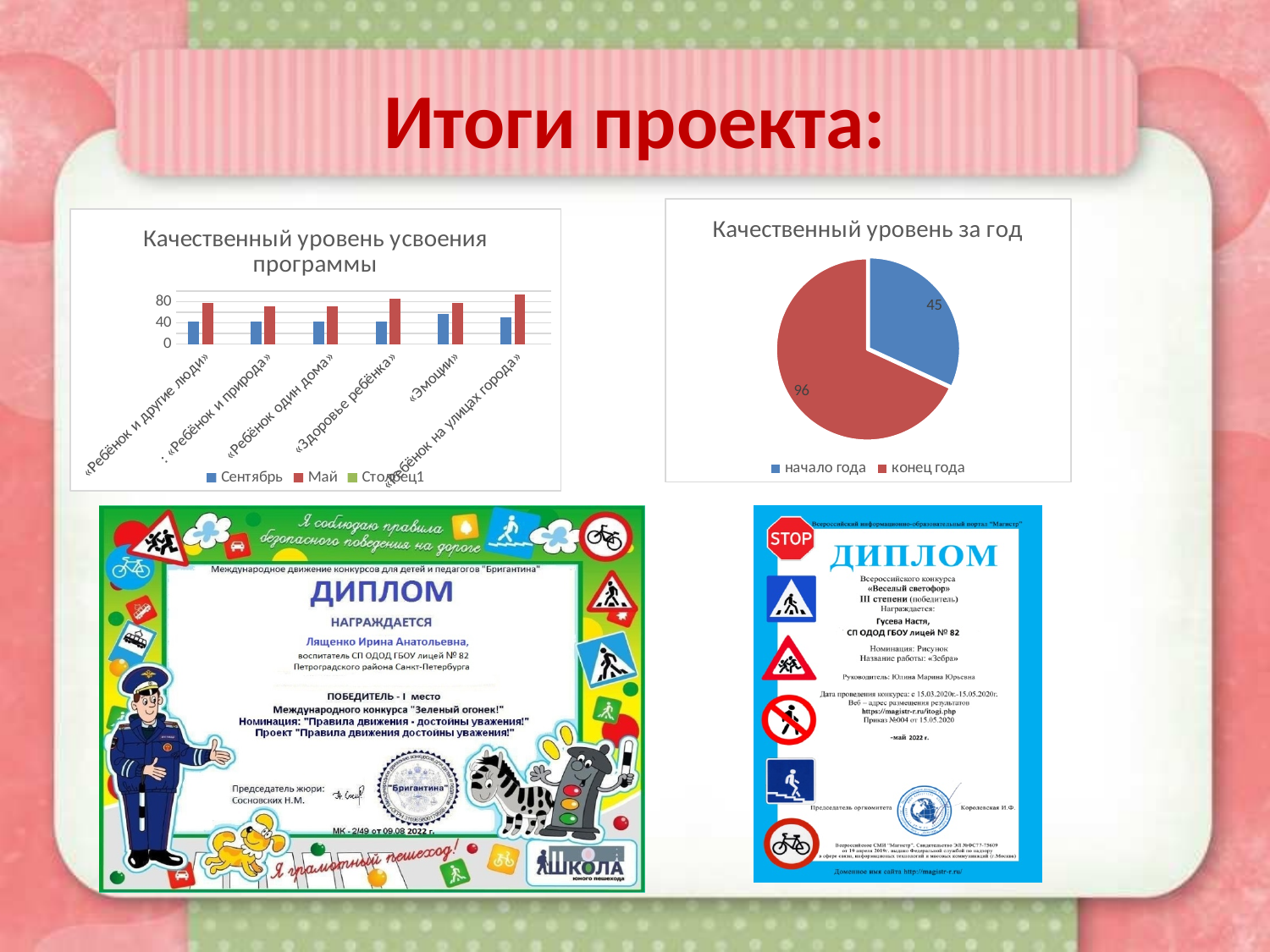
In the chart "Качественный уровень за год", what is the value for начало года? 45 In the chart "Качественный уровень усвоения программы", which is larger for «Ребёнок один дома»: Сентябрь or Май? Май In the chart "Качественный уровень усвоения программы", is the Сентябрь value for «Ребёнок и природа» greater or less than 80? less What type of chart is the chart titled "Качественный уровень за год"? pie chart In the chart "Качественный уровень за год", what is the value for конец года? 96 In the chart "Качественный уровень усвоения программы", is the Май value for «Ребёнок на улицах города» greater or less than 80? greater What type of chart is the chart titled "Качественный уровень усвоения программы"? bar chart In the chart "Качественный уровень за год", what are the two legend entries? начало года, конец года In the chart "Качественный уровень усвоения программы", how many series does the legend list? 3 In the chart "Качественный уровень за год", what is the difference between конец года and начало года? 51 In the chart "Качественный уровень усвоения программы", how many categories are shown on the x axis? 6 In the chart "Качественный уровень за год", which slice is the largest? конец года